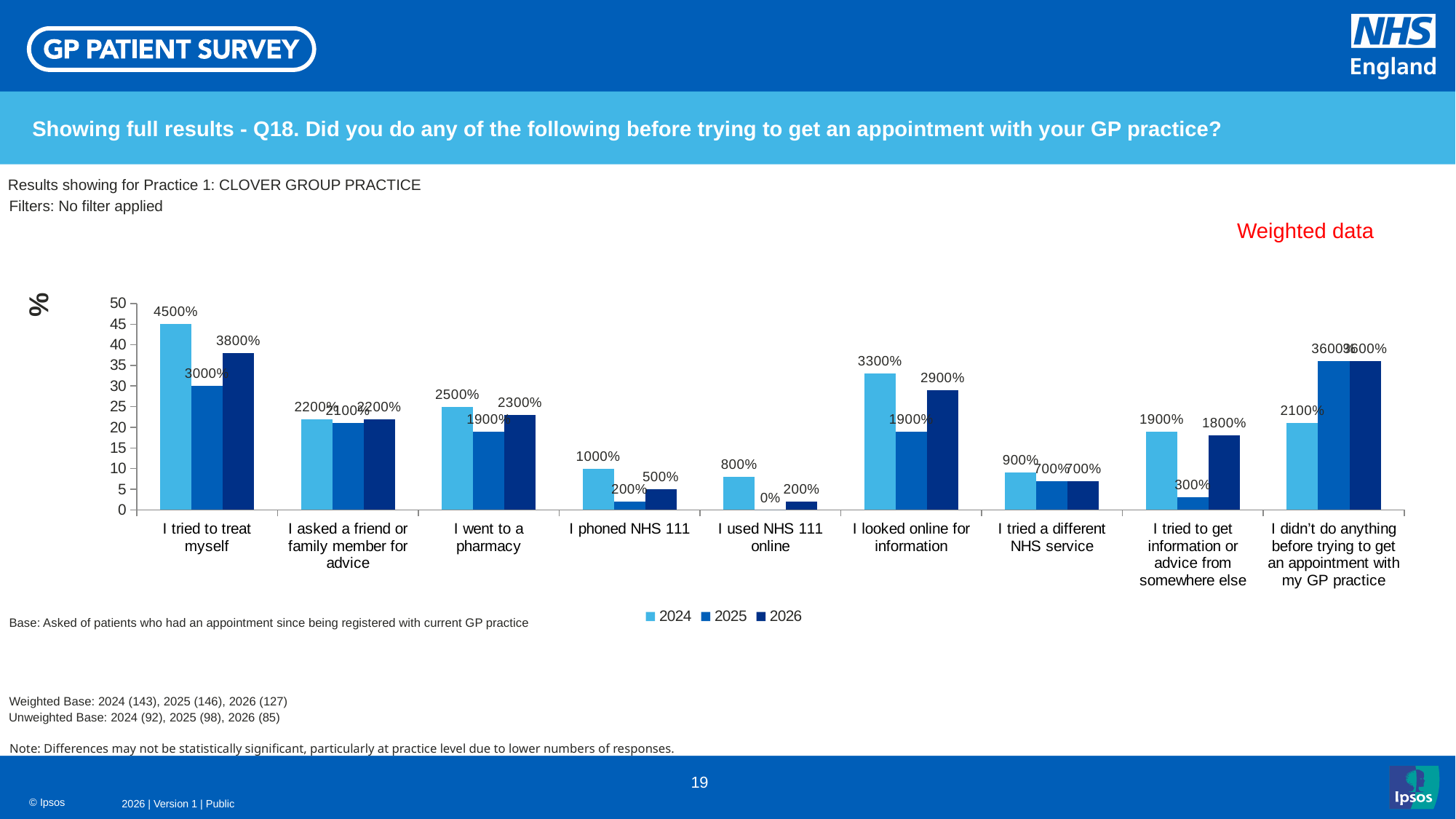
What kind of chart is shown on the slide? bar chart What is the 2026 value for 'I phoned NHS 111'? 500% How many series does the legend list? 3 For 2024, which is larger: 'I went to a pharmacy' or 'I looked online for information'? I looked online for information Which category has the highest 2024 value? I tried to treat myself What is the 2025 value for 'I used NHS 111 online'? 0% What is the 2024 value for 'I tried to treat myself'? 4500% What is the difference between the 2024 and 2025 values for 'I tried to treat myself'? 1500% How many categories are shown on the x axis? 9 What is the 2026 value for 'I looked online for information'? 2900% Is the 2026 value for 'I didn't do anything before trying to get an appointment with my GP practice' greater or less than 30? greater Which category has the lowest 2025 value? I used NHS 111 online